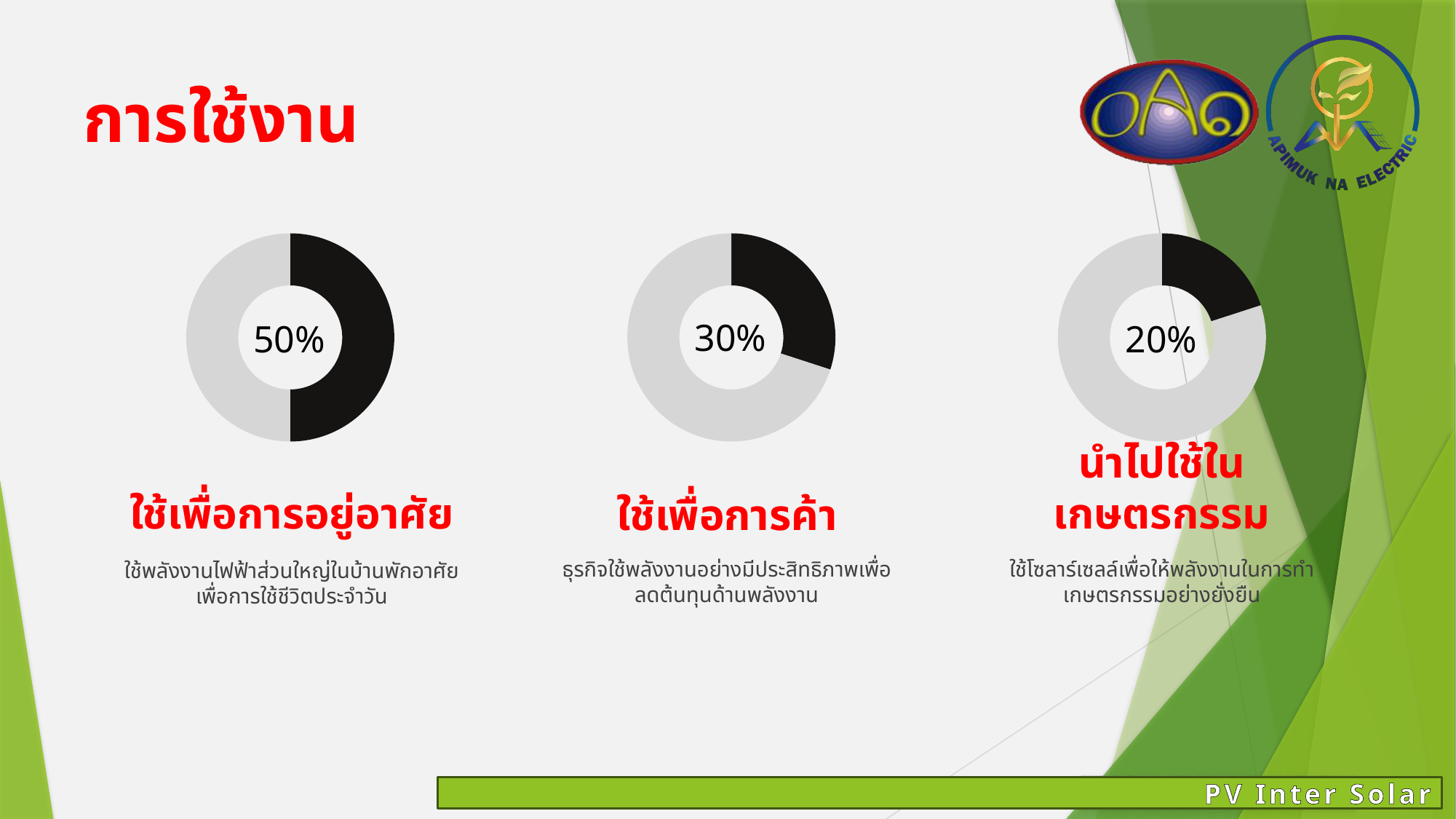
What is the difference between the percentage for ใช้เพื่อการค้า and the percentage for นำไปใช้ในเกษตรกรรม? 10% Which of the three donut charts shows the highest percentage? ใช้เพื่อการอยู่อาศัย (50%) Which is larger: the percentage for ใช้เพื่อการค้า or the percentage for นำไปใช้ในเกษตรกรรม? ใช้เพื่อการค้า How many donut charts are shown on the slide? 3 What is the total of the three percentages shown in the donut charts? 100% What percentage is shown in the donut chart labelled ใช้เพื่อการค้า (middle chart)? 30% What kind of chart is used to show the percentages on this slide? Donut chart What percentage is shown in the donut chart labelled นำไปใช้ในเกษตรกรรม (right chart)? 20% Which of the three donut charts shows the lowest percentage? นำไปใช้ในเกษตรกรรม (20%) What is the title of the slide containing the three donut charts? การใช้งาน What is the difference between the percentage for ใช้เพื่อการอยู่อาศัย and the percentage for ใช้เพื่อการค้า? 20% What percentage is shown in the donut chart labelled ใช้เพื่อการอยู่อาศัย (left chart)? 50%